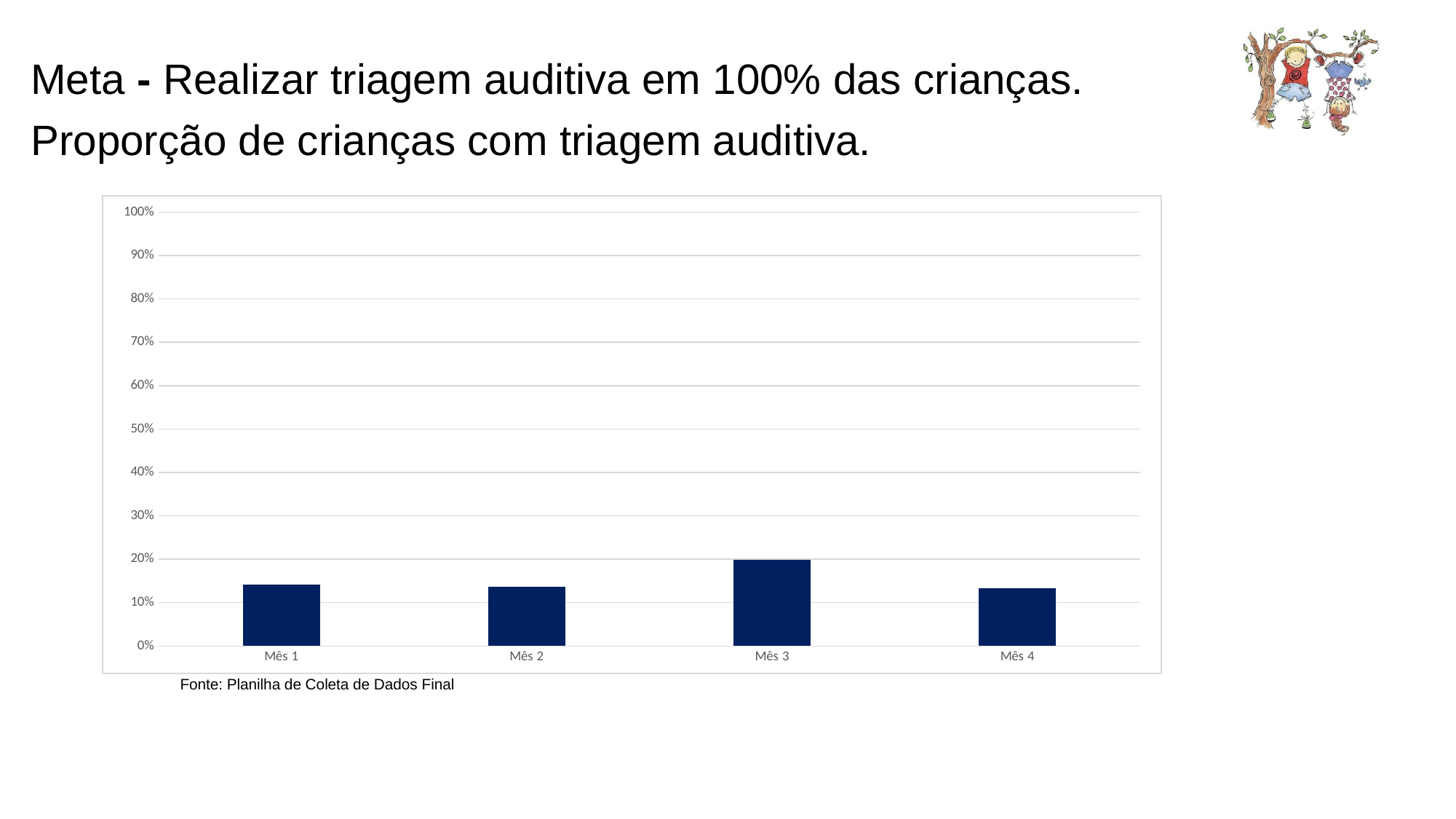
What is the highest value shown on the vertical axis of the chart? 100% What source is cited below the chart? Planilha de Coleta de Dados Final Is the value for Mês 1 greater or less than 10%? greater Is the value for Mês 3 greater or less than 30%? less Which month has the highest proportion of children with hearing screening? Mês 3 Is the value for Mês 3 greater or less than 10%? greater Which is larger, the value for Mês 3 or the value for Mês 4? Mês 3 How many categories (months) are plotted on the chart? 4 What kind of chart is shown on the slide? bar chart